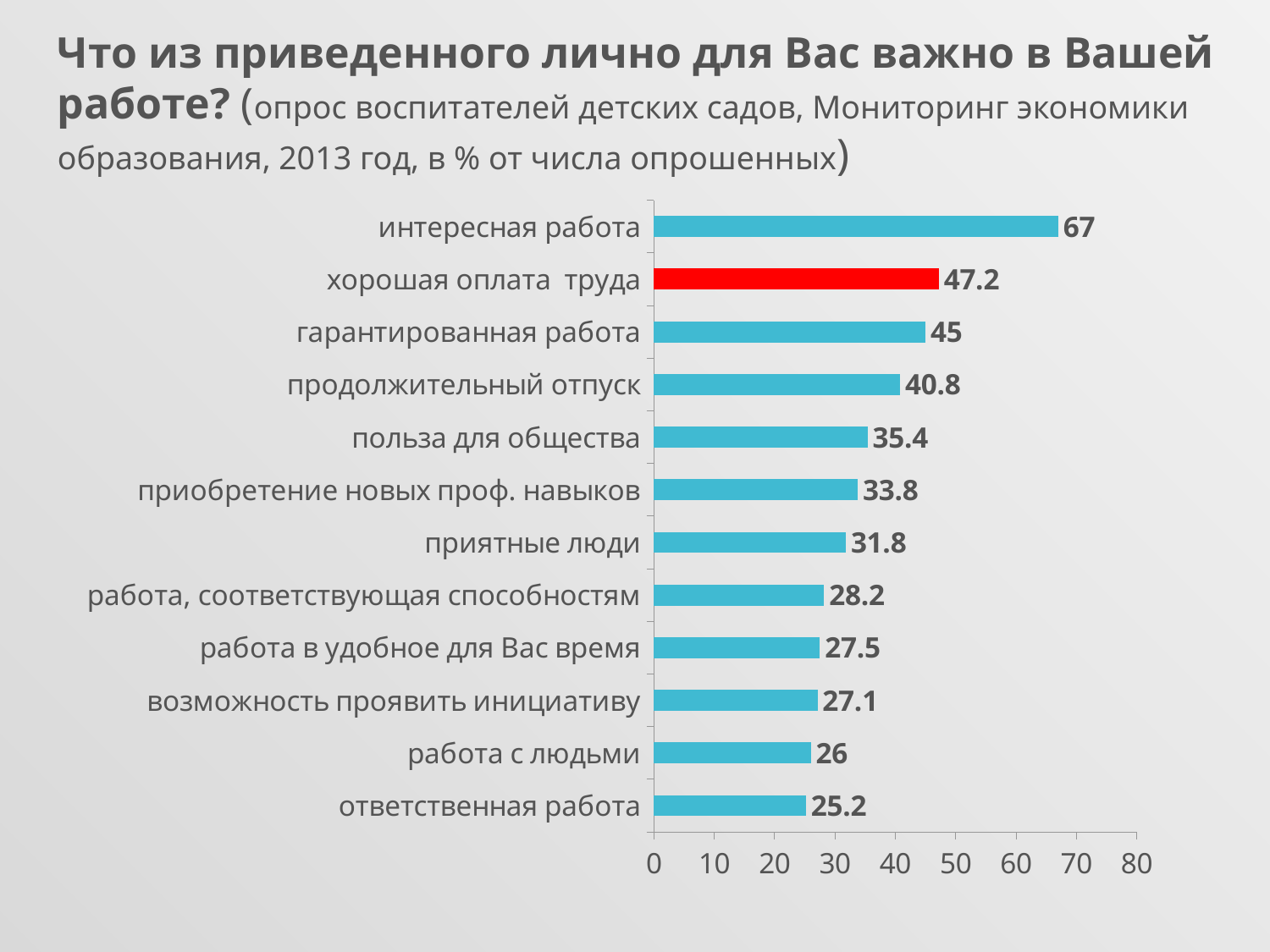
Which bar is coloured red instead of blue? хорошая оплата труда Is the value for "гарантированная работа" greater or less than 40? greater Which category has the lowest value? ответственная работа What is the value for "продолжительный отпуск"? 40.8 What is the value for "ответственная работа"? 25.2 What is the difference between the values for "интересная работа" and "хорошая оплата труда"? 19.8 Which category has the highest value? интересная работа What is the value for "интересная работа"? 67 Which is larger, the value for "польза для общества" or the value for "приятные люди"? польза для общества How many categories are shown in the chart? 12 What kind of chart is shown on the slide? bar chart What is the value for "хорошая оплата труда"? 47.2